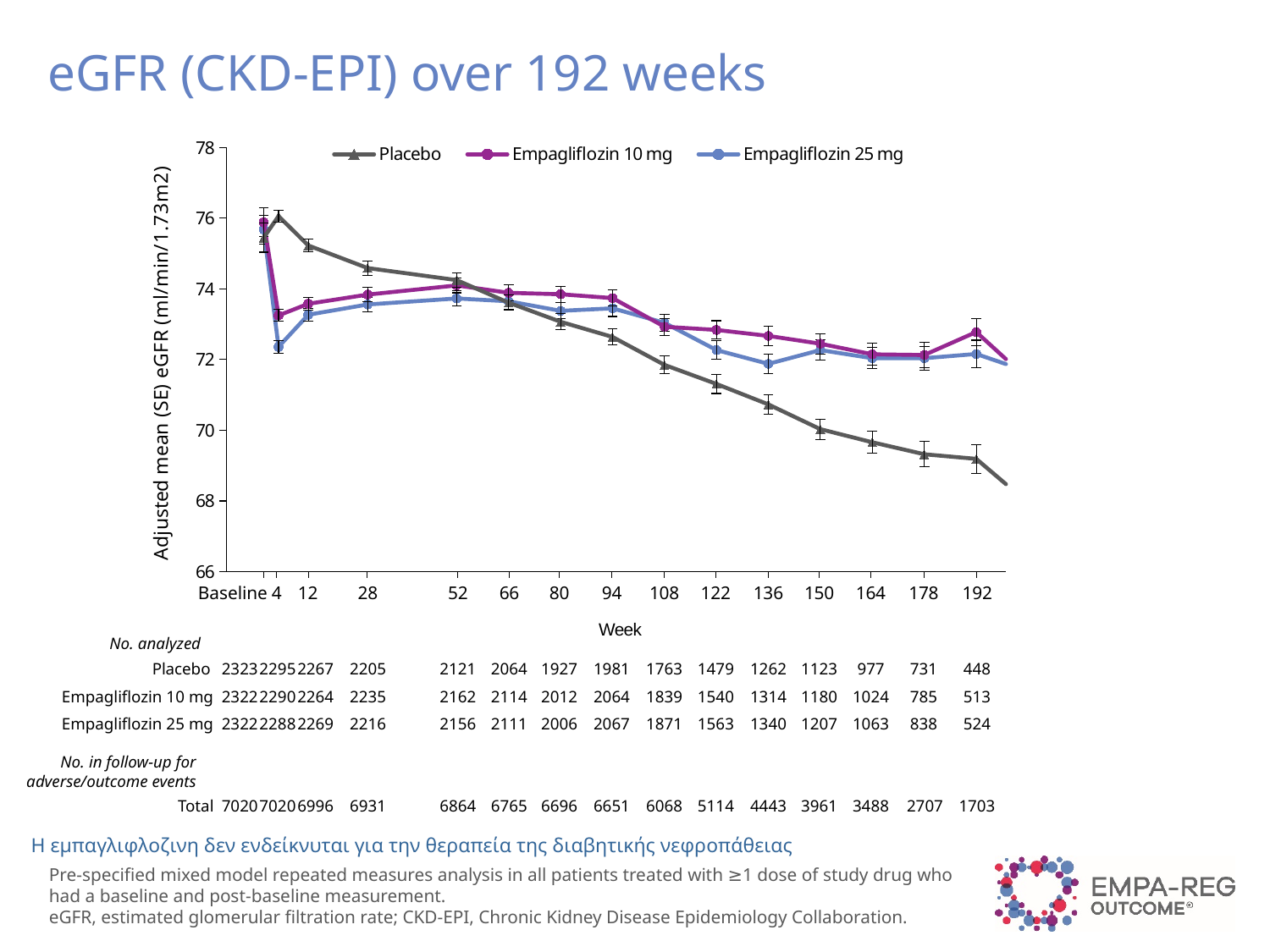
At week 192, which is higher: Placebo or Empagliflozin 10 mg? Empagliflozin 10 mg How many series does the legend list? 3 In the No. analyzed table, what is the difference between Empagliflozin 25 mg and Empagliflozin 10 mg at week 192? 11 Is the Placebo value at week 136 greater or less than 70? greater Is the Placebo value at week 192 greater or less than 70? less At week 4, which is higher: Placebo or Empagliflozin 25 mg? Placebo Does the Placebo line rise or fall from week 4 to week 192? fall What kind of chart is shown on the slide? line chart In the No. analyzed table, how many Placebo patients were analyzed at week 192? 448 Is the Empagliflozin 25 mg value at week 4 greater or less than 74? less What is the title of the chart? eGFR (CKD-EPI) over 192 weeks What is the label of the y axis? Adjusted mean (SE) eGFR (ml/min/1.73m2)